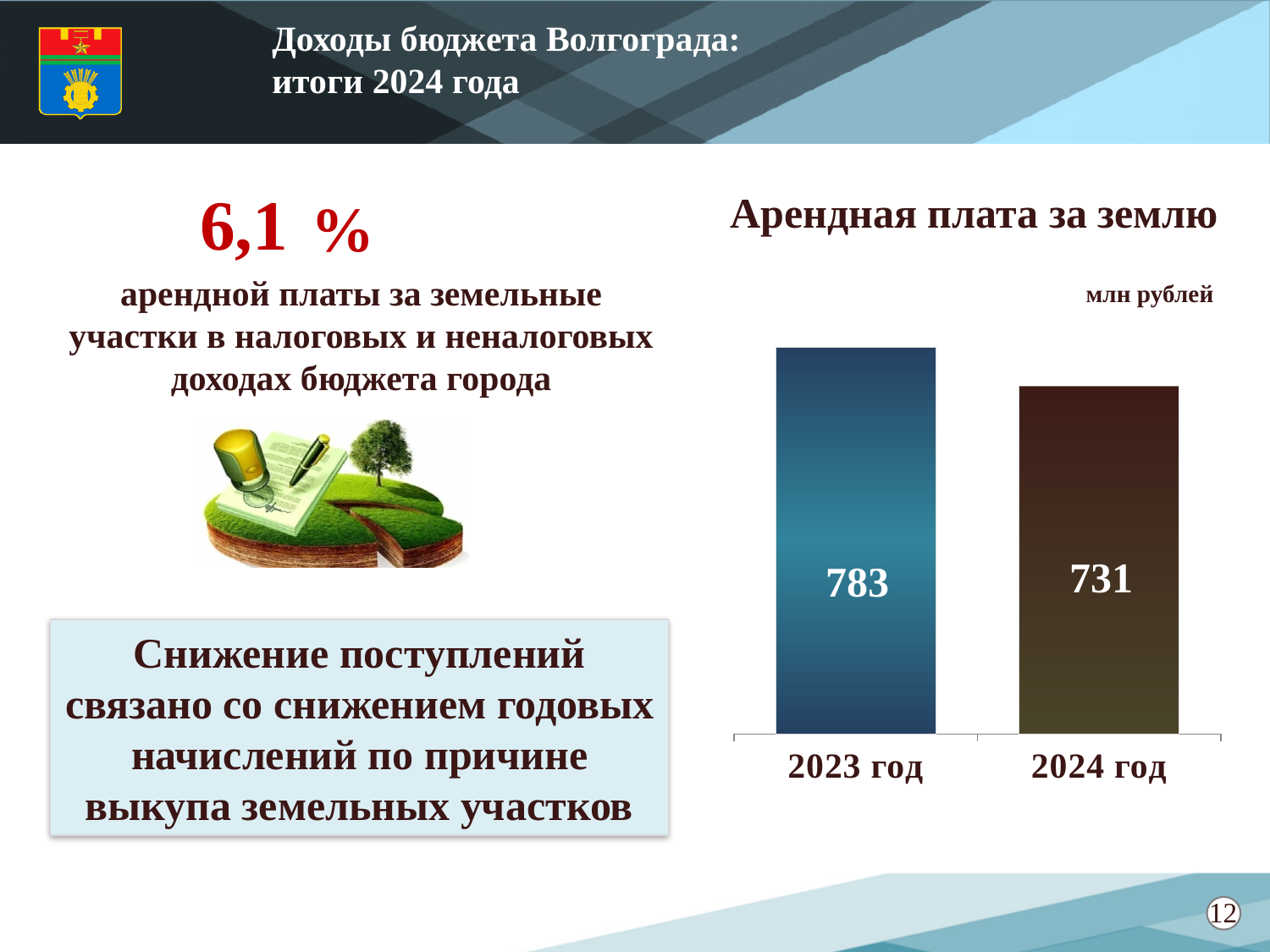
Which year has the highest value in the chart? 2023 год What is the difference between the values for 2023 год and 2024 год? 52 Do the values rise or fall from 2023 год to 2024 год? Fall Which is larger, the value for 2023 год or for 2024 год? 2023 год What is the value for 2023 год in the chart? 783 What kind of chart is shown on the slide? Bar chart Which year has the lowest value in the chart? 2024 год How many categories are shown in the chart? 2 What unit is indicated for the chart values? млн рублей What is the value for 2024 год in the chart? 731 What is the title of the chart? Арендная плата за землю